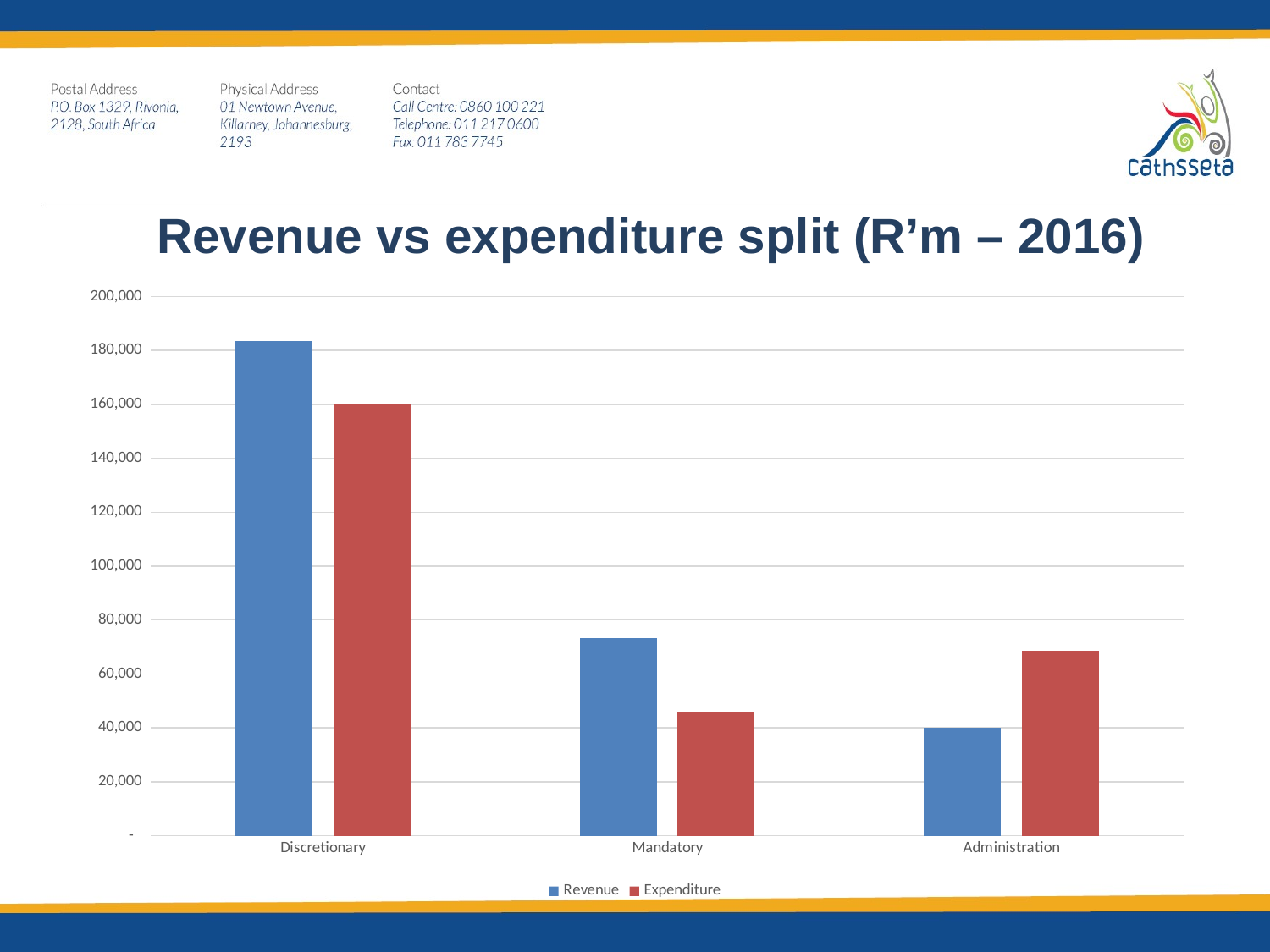
Which category has the highest Expenditure? Discretionary Which category has the lowest Expenditure? Mandatory What kind of chart is shown on the slide? bar chart For Mandatory, which is larger, Revenue or Expenditure? Revenue For Administration, which is larger, Revenue or Expenditure? Expenditure What is the title of the chart? Revenue vs expenditure split (R'm – 2016) Which category has the highest Revenue? Discretionary How many categories are shown on the x axis? 3 How many series does the legend list? 2 Is the Revenue value for Discretionary greater or less than 180,000? greater Is the Expenditure value for Mandatory greater or less than 60,000? less Which category has the lowest Revenue? Administration